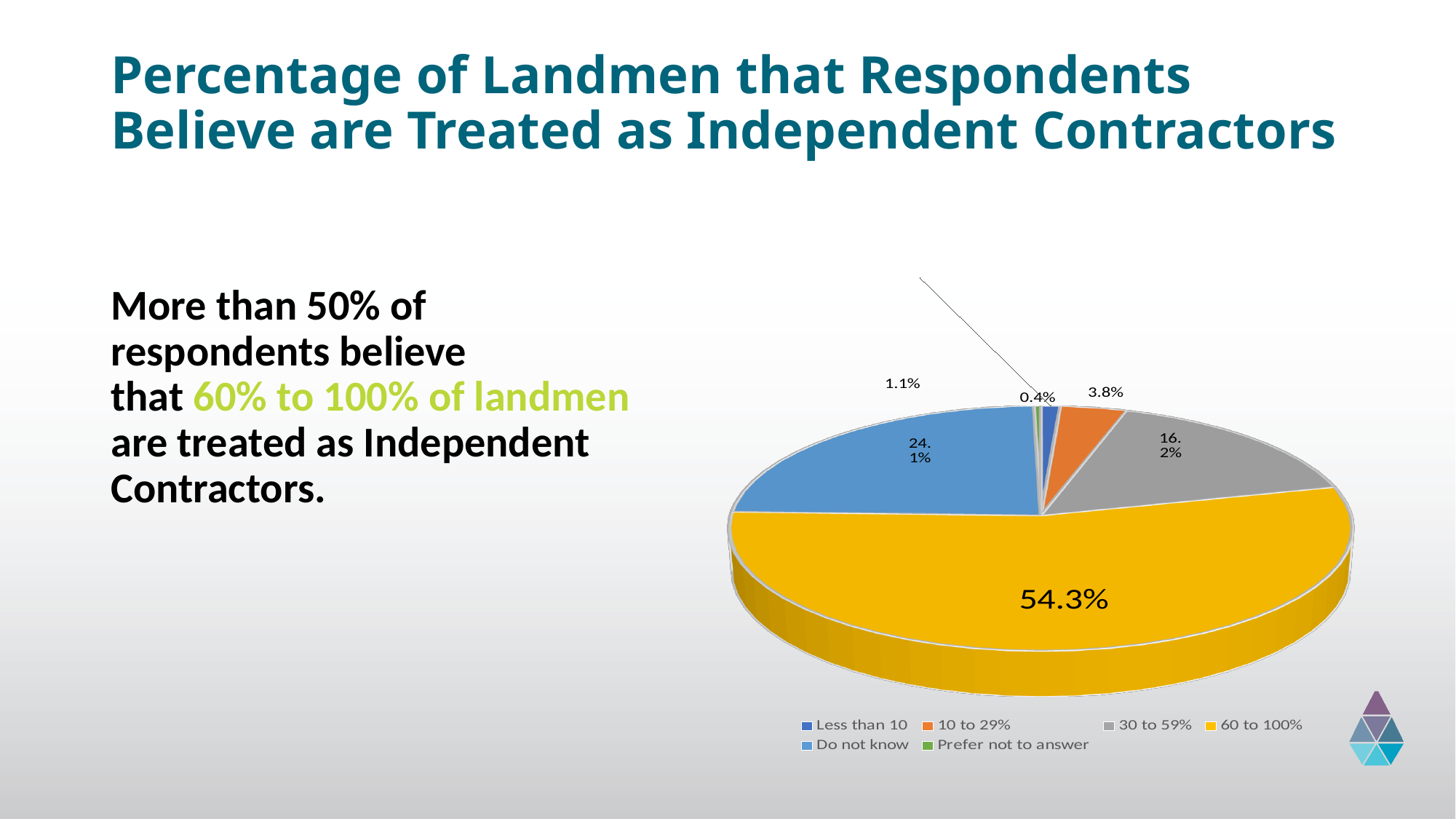
What is the difference in percentage points between the "60 to 100%" slice and the "Do not know" slice? 30.2 Which category has the largest slice of the pie? 60 to 100% What percentage of respondents chose "60 to 100%"? 54.3% What is the difference in percentage points between the "30 to 59%" slice and the "10 to 29%" slice? 12.4 What percentage of respondents chose "10 to 29%"? 3.8% Which slice is larger: "Do not know" or "30 to 59%"? Do not know What is the difference in percentage points between the "Do not know" slice and the "30 to 59%" slice? 7.9 What percentage of respondents chose "30 to 59%"? 16.2% What colour is the "60 to 100%" slice of the pie? yellow What kind of chart is shown on the slide? pie chart What percentage of respondents answered "Do not know"? 24.1% How many categories does the legend list? 6